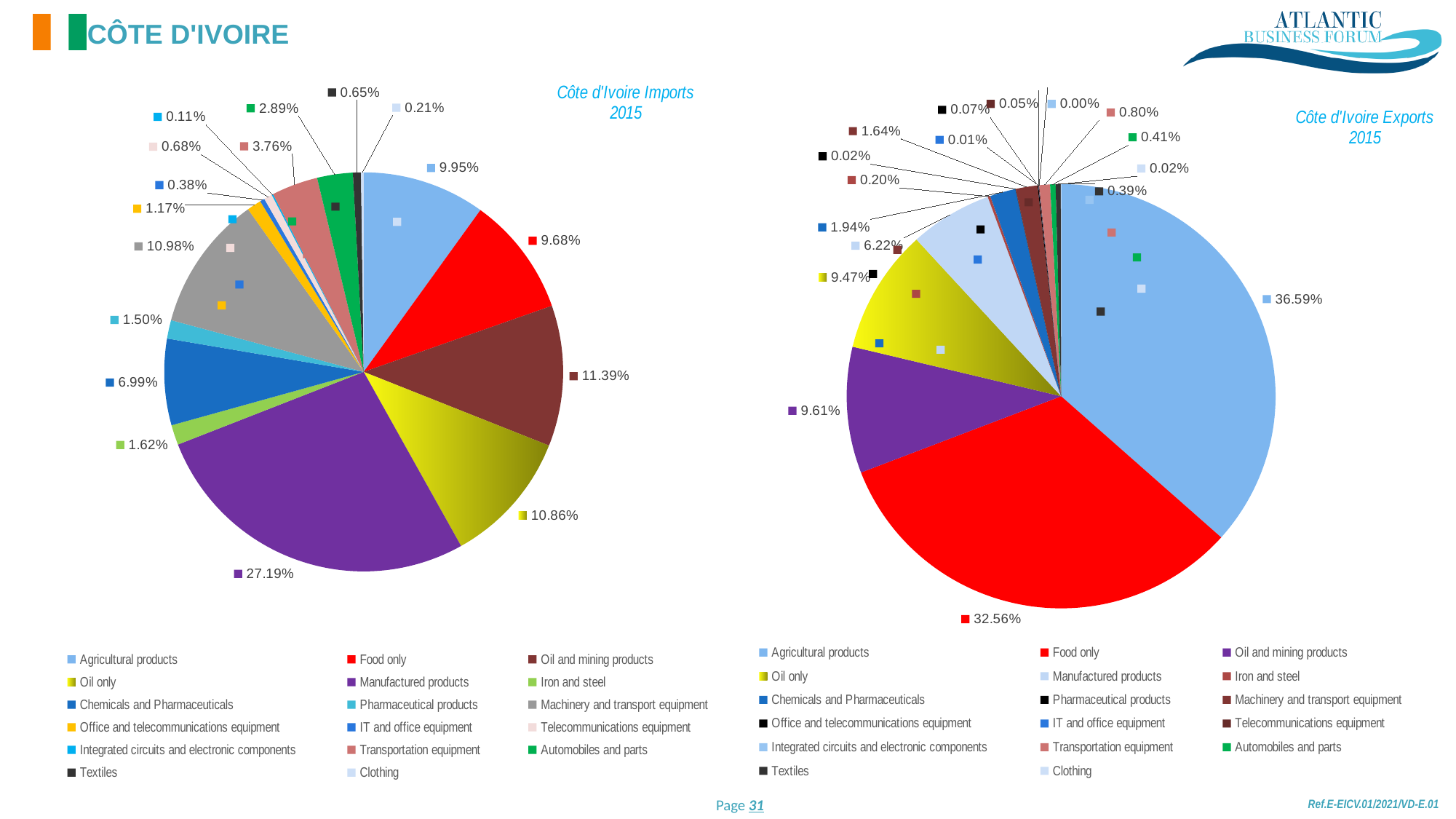
In the Côte d'Ivoire Imports 2015 chart, what is the difference between the shares for Oil and mining products and Oil only? 0.53 percentage points In the Côte d'Ivoire Exports 2015 chart, what is the difference between the shares for Agricultural products and Food only? 4.03 percentage points In the Côte d'Ivoire Exports 2015 chart, what share is shown for Agricultural products? 36.59% How many categories does the legend of the Côte d'Ivoire Imports 2015 chart list? 17 In the Côte d'Ivoire Imports 2015 chart, which category has the largest slice? Manufactured products In the Côte d'Ivoire Imports 2015 chart, what share is shown for Oil and mining products? 11.39% What kind of chart is the Côte d'Ivoire Exports 2015 chart? Pie chart In the Côte d'Ivoire Exports 2015 chart, which is larger: Agricultural products or Food only? Agricultural products In the Côte d'Ivoire Exports 2015 chart, what share is shown for Food only? 32.56% In the Côte d'Ivoire Imports 2015 chart, what share is shown for Manufactured products? 27.19% In the Côte d'Ivoire Imports 2015 chart, what share is shown for Chemicals and Pharmaceuticals? 6.99% In the Côte d'Ivoire Exports 2015 chart, which category has the largest slice? Agricultural products